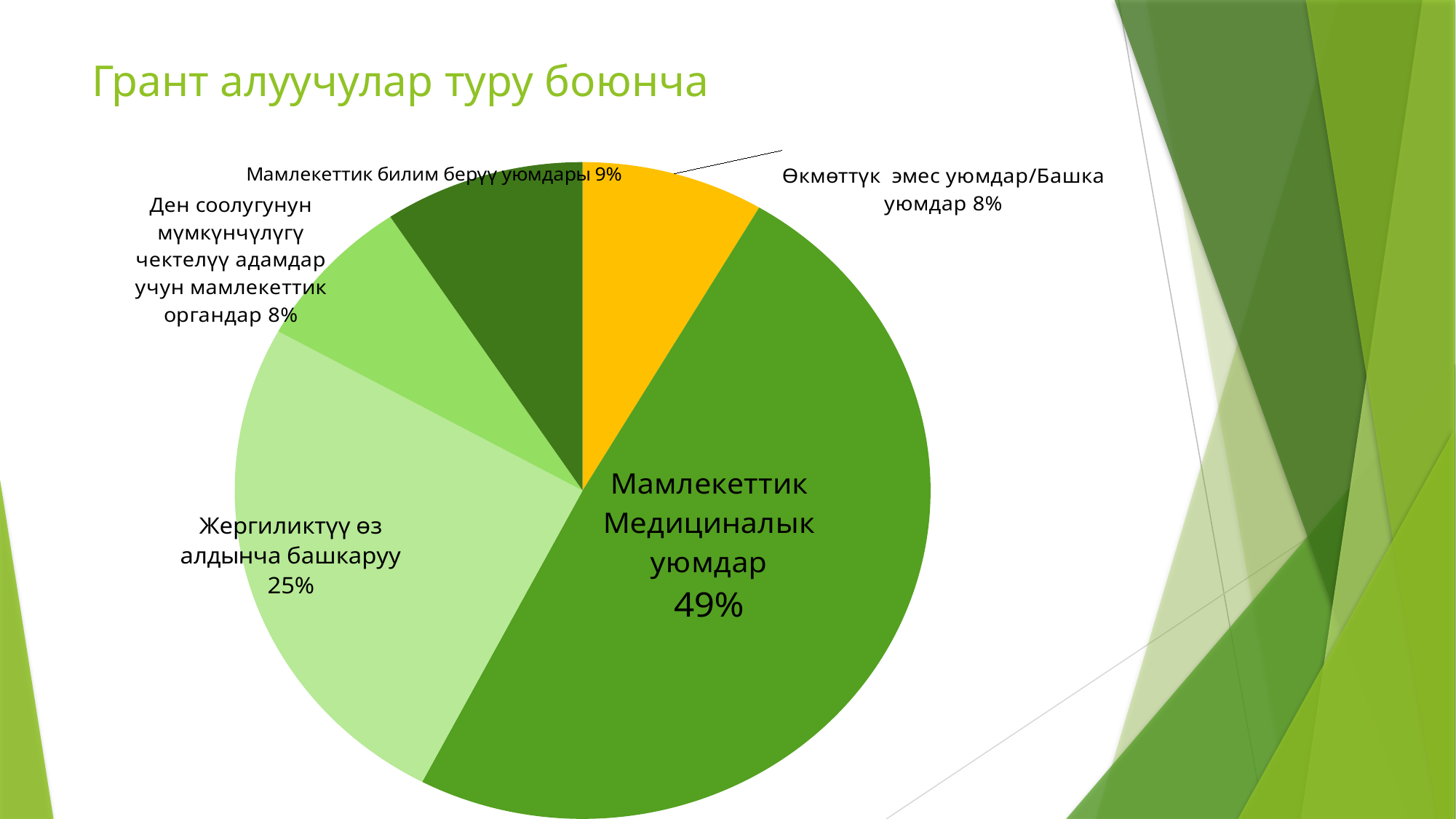
What kind of chart is shown on the slide? Pie chart What share of the pie is Ден соолугунун мүмкүнчүлүгү чектелүү адамдар учун мамлекеттик органдар? 8% What share of the pie is Жергиликтүү өз алдынча башкаруу? 25% What colour is the slice for Өкмөттүк эмес уюмдар/Башка уюмдар? Yellow/orange What is the title of the chart on the slide? Грант алуучулар туру боюнча Which is larger: the share for Мамлекеттик билим берүү уюмдары or the share for Өкмөттүк эмес уюмдар/Башка уюмдар? Мамлекеттик билим берүү уюмдары What share of the pie is Мамлекеттик Медициналык уюмдар? 49% How many slices does the pie chart have? 5 Which category has the largest share of the pie? Мамлекеттик Медициналык уюмдар What is the difference in percentage points between Мамлекеттик Медициналык уюмдар and Жергиликтүү өз алдынча башкаруу? 24 percentage points